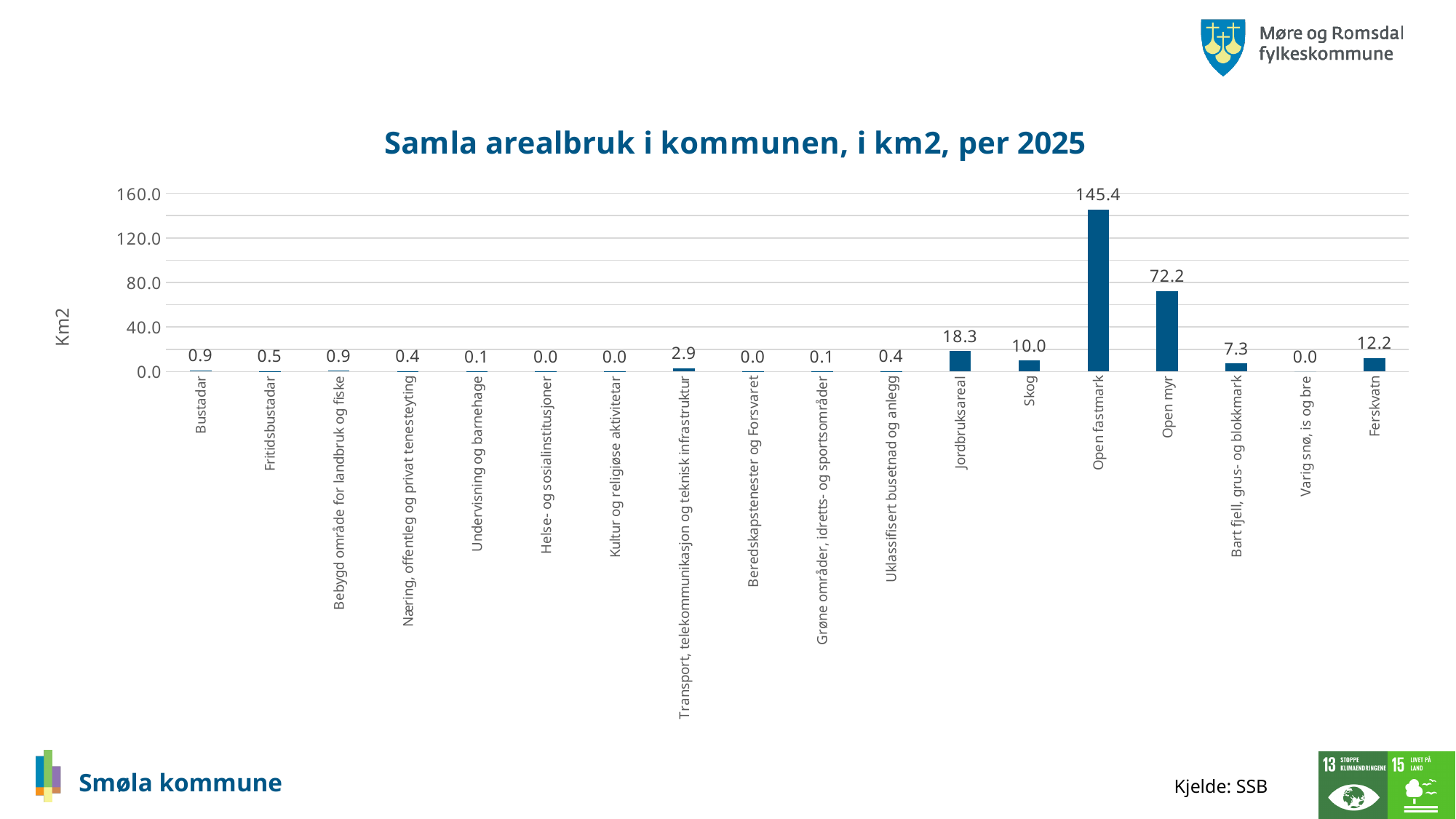
What is the value for Open myr? 72.2 What is the value for Ferskvatn? 12.2 Which category has the highest value? Open fastmark Is the value for Open myr greater or less than 80.0? less What is the value for Jordbruksareal? 18.3 What is the difference between the values for Jordbruksareal and Skog? 8.3 What is the value for Transport, telekommunikasjon og teknisk infrastruktur? 2.9 Which is larger, the value for Ferskvatn or the value for Skog? Ferskvatn How many categories are shown on the x axis? 18 What type of chart is shown on the slide? bar chart What is the value for Open fastmark? 145.4 What is the difference between the values for Open fastmark and Open myr? 73.2